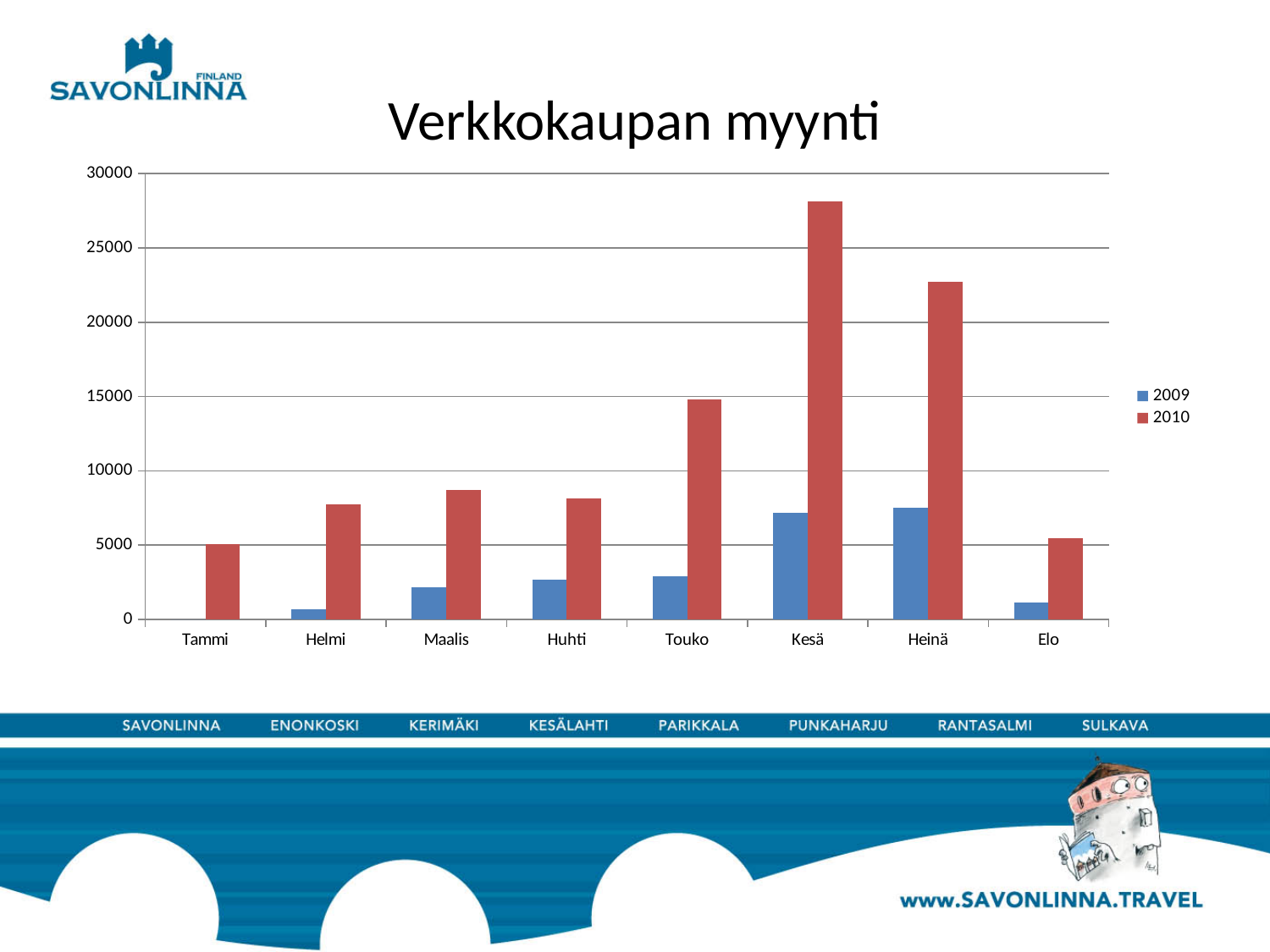
What kind of chart is shown on the slide? bar chart Which month has the highest value for 2010? Kesä How many months are shown on the x axis? 8 Do the 2009 values rise or fall from Tammi to Heinä? rise Is the 2010 value for Touko greater or less than 10000? greater Is the 2009 value for Kesä greater or less than 10000? less What is the title of the chart? Verkkokaupan myynti Which is larger, the 2010 value for Kesä or the 2010 value for Heinä? Kesä Is the 2010 value for Kesä greater or less than 25000? greater How many series does the legend list? 2 For Maalis, which series has the larger value, 2009 or 2010? 2010